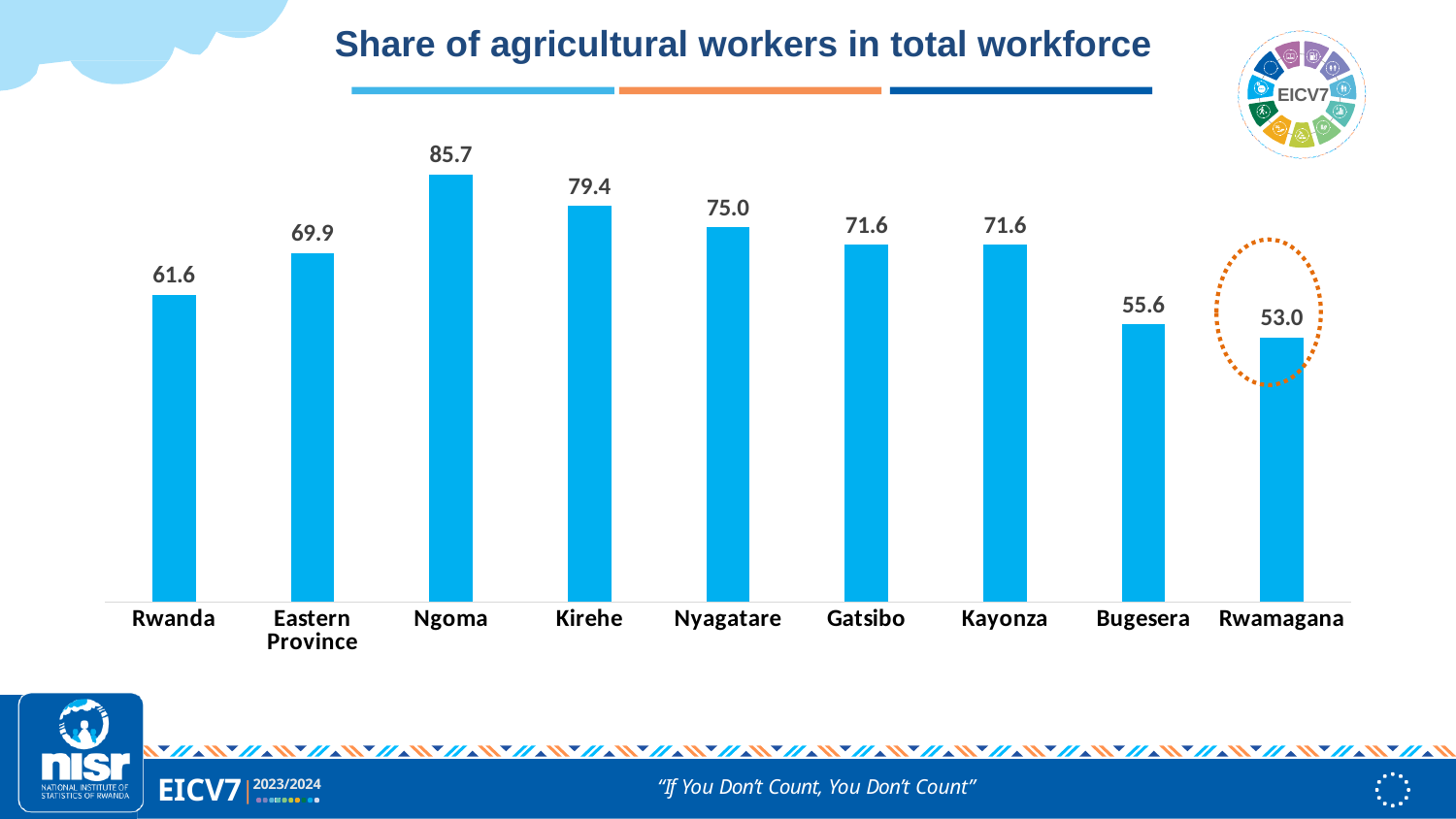
What is the difference between the values for Ngoma and Rwamagana? 32.7 Which category has the lowest share of agricultural workers? Rwamagana What is the value shown for Rwamagana? 53.0 What is the title of the chart? Share of agricultural workers in total workforce Which category has the highest share of agricultural workers? Ngoma Which is larger, the value for Bugesera or the value for Rwanda? Rwanda How many categories are shown on the x axis? 9 What is the share of agricultural workers in the total workforce for Ngoma? 85.7 What is the difference between the values for Kirehe and Nyagatare? 4.4 What is the value shown for Eastern Province? 69.9 What is the value shown for Rwanda? 61.6 What kind of chart is shown on the slide? Bar chart